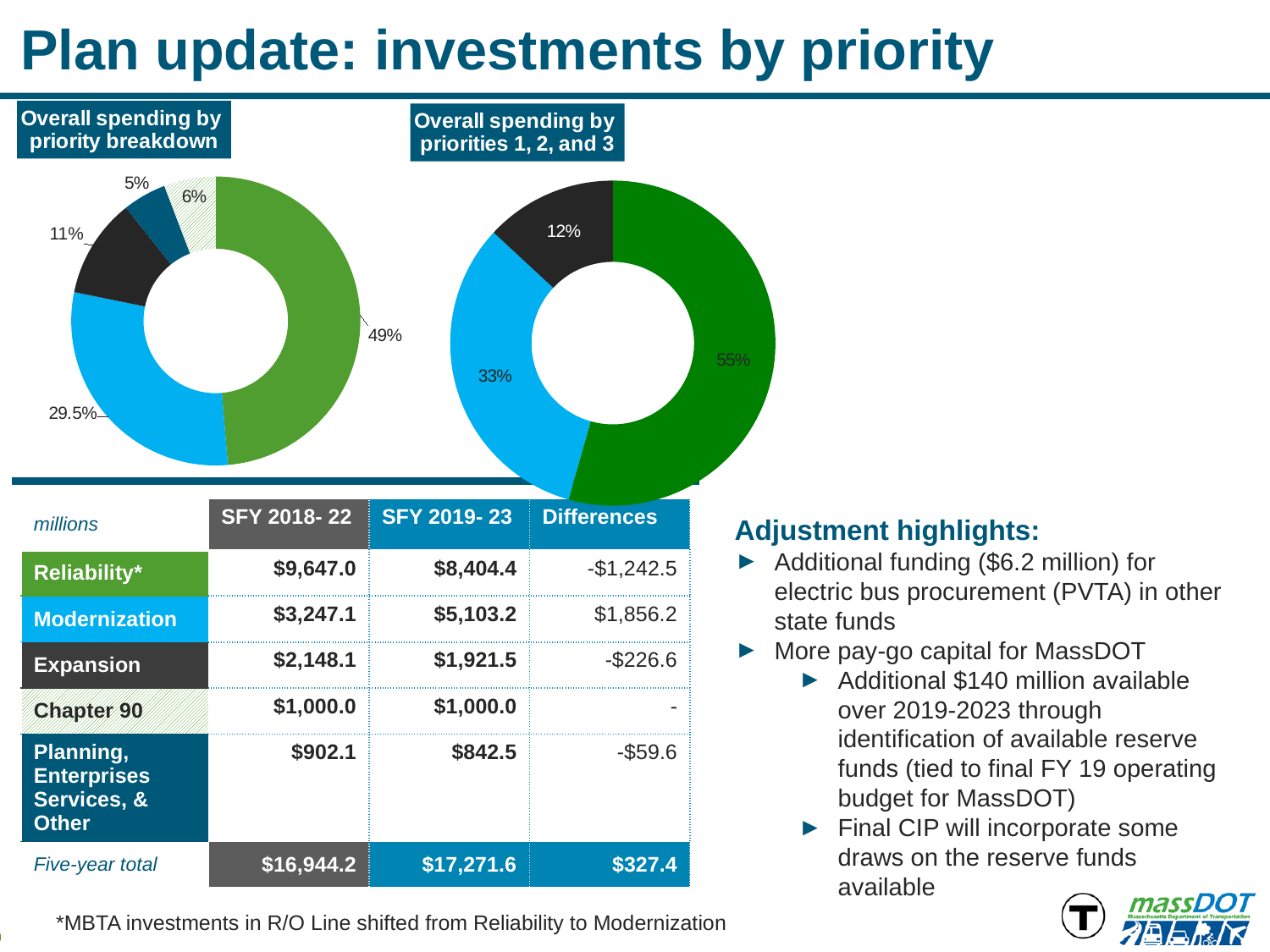
In the 'Overall spending by priority breakdown' chart, what is the difference between the largest slice (49%) and the 29.5% slice? 19.5% In the 'Overall spending by priorities 1, 2, and 3' chart, what is the difference between the 55% slice and the 33% slice? 22% In the 'Overall spending by priority breakdown' chart, which is larger: the dark gray slice (11%) or the hatched slice (6%)? The dark gray slice (11%) In the 'Overall spending by priorities 1, 2, and 3' chart, what share does the largest slice represent? 55% How many slices does the 'Overall spending by priority breakdown' chart have? 5 What is the title of the chart on the right? Overall spending by priorities 1, 2, and 3 In the 'Overall spending by priority breakdown' chart, what share does the light blue slice represent? 29.5% In the 'Overall spending by priority breakdown' chart, what is the largest slice's share? 49% In the 'Overall spending by priorities 1, 2, and 3' chart, what share does the smallest slice represent? 12% How many slices does the 'Overall spending by priorities 1, 2, and 3' chart have? 3 What kind of chart is the 'Overall spending by priority breakdown' chart? Pie (donut) chart In the 'Overall spending by priority breakdown' chart, what is the smallest slice's share? 5%